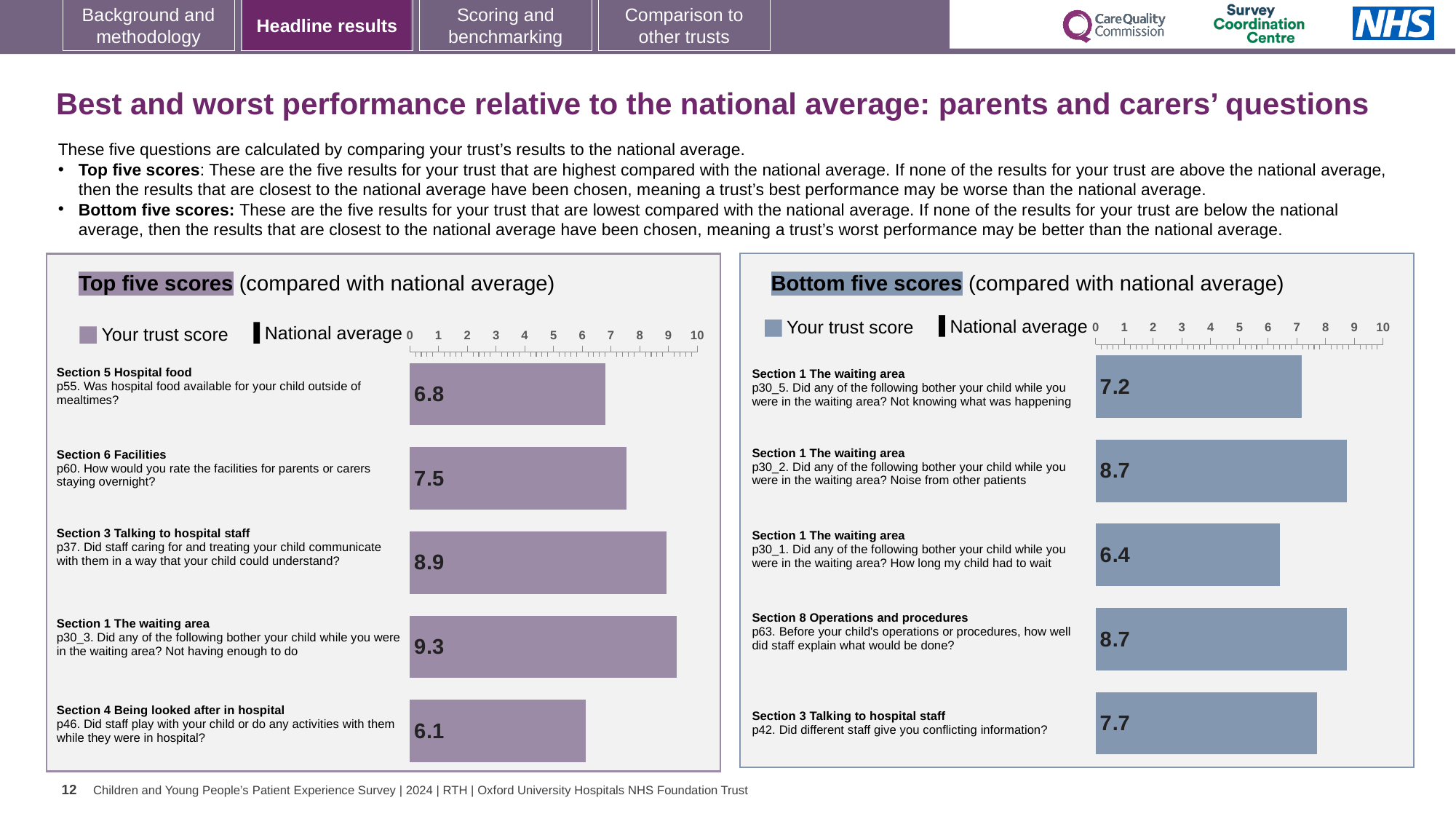
In the Top five scores chart, which question has the highest trust score? p30_3. Did any of the following bother your child while you were in the waiting area? Not having enough to do In the Bottom five scores chart, which question has the lowest trust score? p30_1. Did any of the following bother your child while you were in the waiting area? How long my child had to wait In the Bottom five scores chart, what is the trust score for p42 (Did different staff give you conflicting information?)? 7.7 In the Top five scores chart, what is the difference between the highest trust score (9.3) and the lowest trust score (6.1)? 3.2 In the Top five scores chart, which question has the lowest trust score? p46. Did staff play with your child or do any activities with them while they were in hospital? What kind of chart is the Top five scores chart? Bar chart In the Bottom five scores chart, what is the difference between the trust score for p30_2 (Noise from other patients) and p30_1 (How long my child had to wait)? 2.3 In the Bottom five scores chart, what is the trust score for p30_5 (Not knowing what was happening in the waiting area)? 7.2 In the Top five scores chart, what is the trust score for p55 (Was hospital food available for your child outside of mealtimes?)? 6.8 How many questions are plotted in the Bottom five scores chart? 5 In the Top five scores chart, what is the trust score for p37 (Did staff caring for and treating your child communicate with them in a way that your child could understand?)? 8.9 In the Top five scores chart, which has the larger trust score: p60 (facilities for parents or carers staying overnight) or p55 (hospital food available outside of mealtimes)? p60